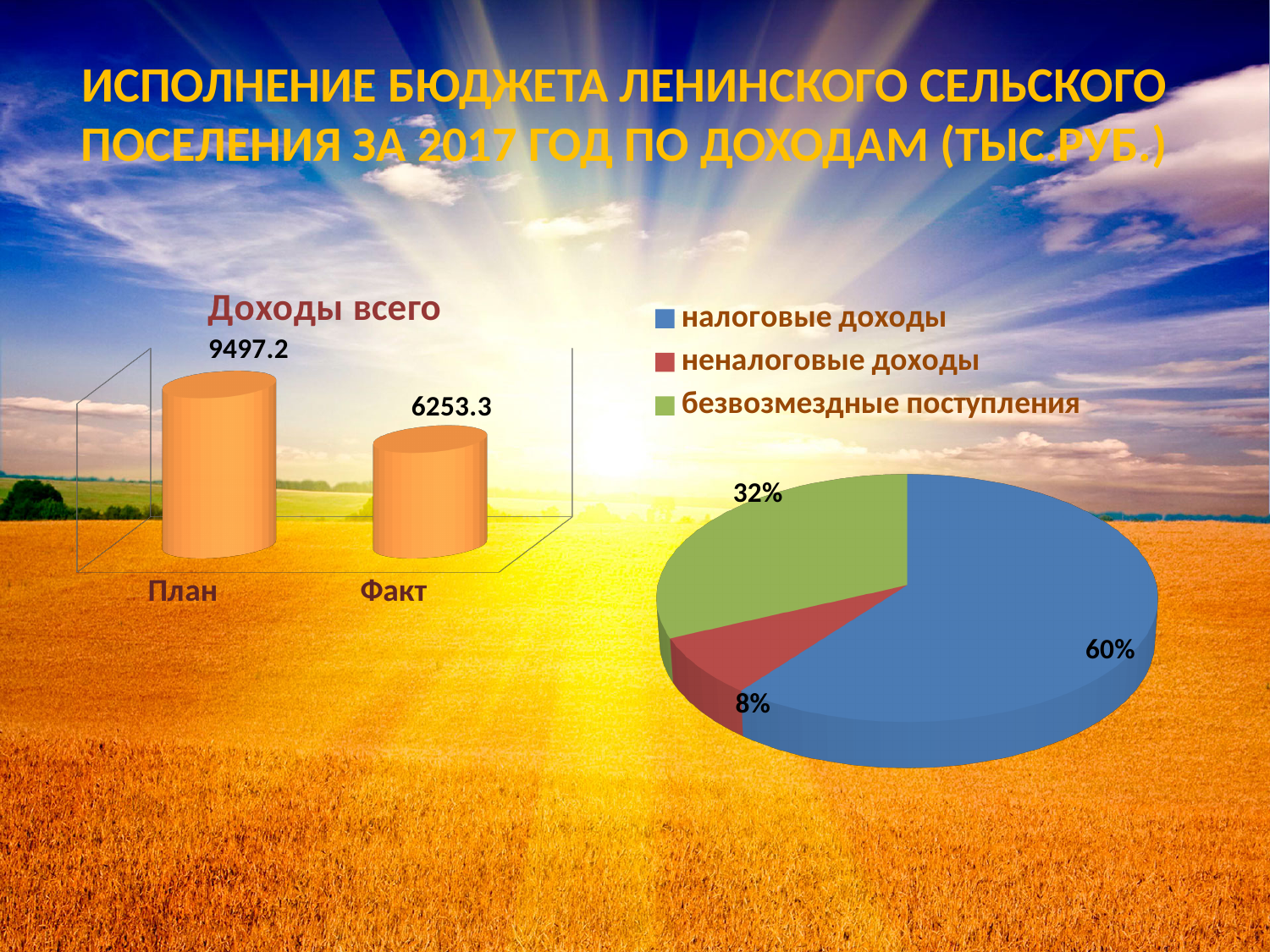
In the bar chart titled "Доходы всего", how many categories are shown? 2 In the pie chart on the right, which category has the smallest slice? неналоговые доходы In the bar chart titled "Доходы всего", which category has the higher value? План In the pie chart on the right, what share does безвозмездные поступления have? 32% What kind of chart is the chart on the left titled "Доходы всего"? Bar chart In the pie chart on the right, which is larger: безвозмездные поступления or неналоговые доходы? безвозмездные поступления How many entries does the legend of the pie chart on the right list? 3 In the pie chart on the right, what share does налоговые доходы have? 60% In the bar chart titled "Доходы всего", what is the value for План? 9497.2 In the pie chart on the right, what share does неналоговые доходы have? 8% In the bar chart titled "Доходы всего", what is the difference between План and Факт? 3243.9 In the bar chart titled "Доходы всего", what is the value for Факт? 6253.3